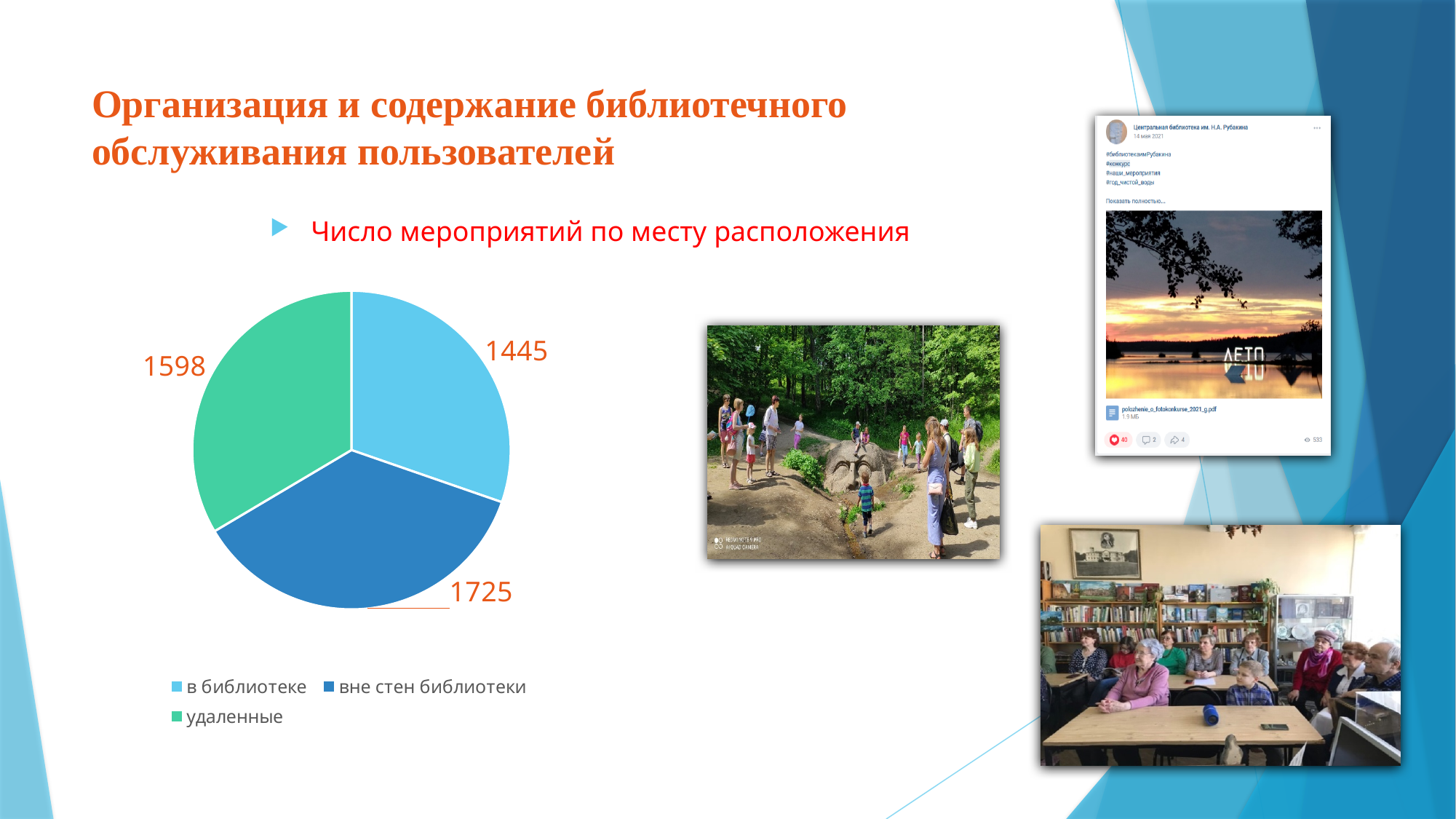
What is the difference between the values for "вне стен библиотеки" and "в библиотеке"? 280 How many slices does the pie chart have? 3 What is the total of all three slices? 4768 Which category has the lowest value? в библиотеке Which category has the highest value? вне стен библиотеки What is the value for "вне стен библиотеки"? 1725 What kind of chart is shown on the slide? pie chart Which is larger, the value for "удаленные" or the value for "в библиотеке"? удаленные What is the value for "удаленные"? 1598 How many entries does the legend list? 3 What is the value for "в библиотеке"? 1445 What is the title of the chart? Число мероприятий по месту расположения